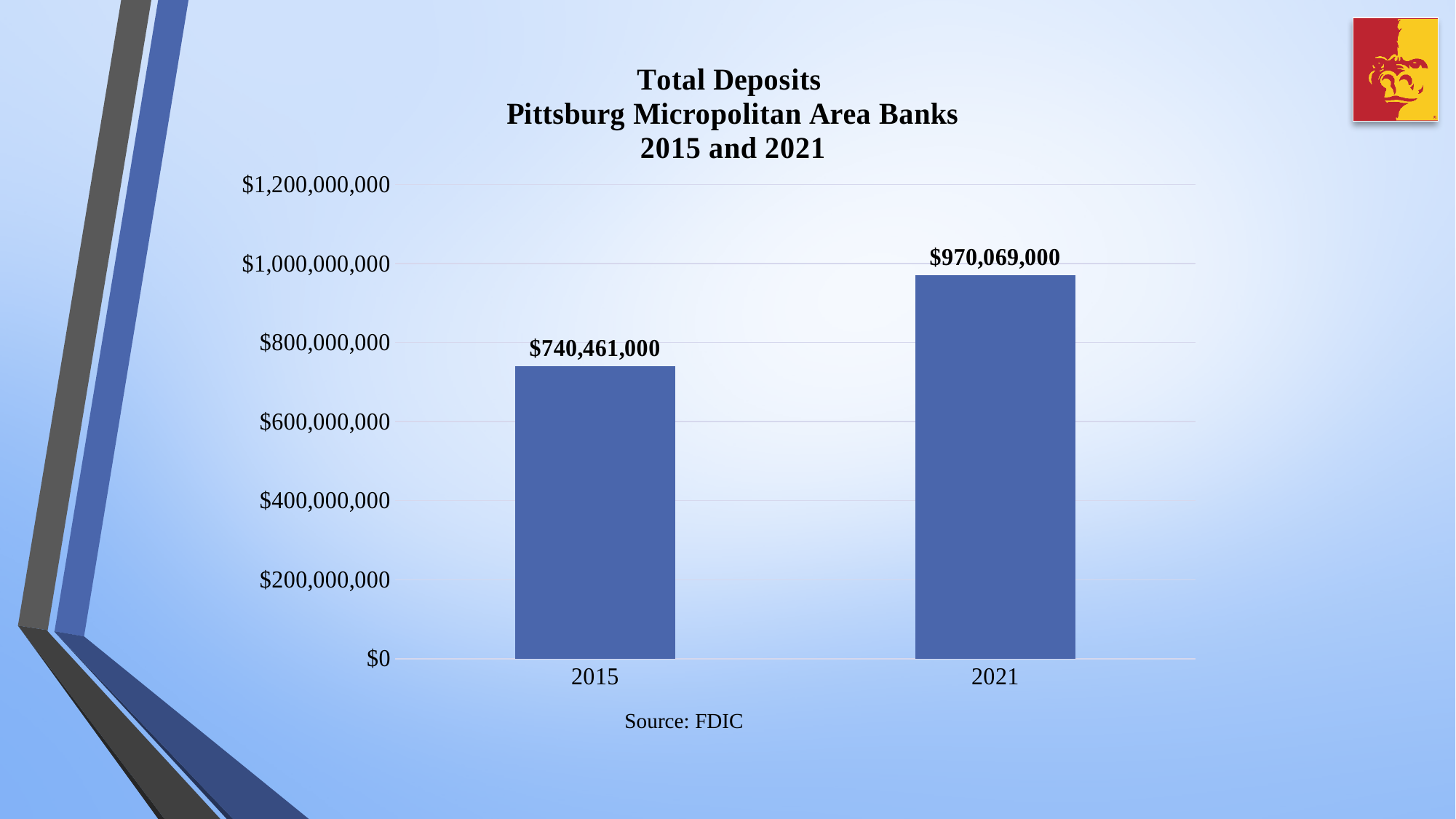
What were total deposits for Pittsburg Micropolitan Area Banks in 2015? $740,461,000 What kind of chart is shown on the slide? Bar chart Is the value for 2015 greater or less than $600,000,000? greater How many years are shown on the chart? 2 Are total deposits larger in 2015 or in 2021? 2021 What were total deposits for Pittsburg Micropolitan Area Banks in 2021? $970,069,000 By how much did total deposits increase from 2015 to 2021? $229,608,000 Do total deposits rise or fall from 2015 to 2021? Rise Which year shows the higher total deposits? 2021 What is the source cited for the chart data? FDIC Which year shows the lower total deposits? 2015 Is the value for 2021 greater or less than $1,000,000,000? less